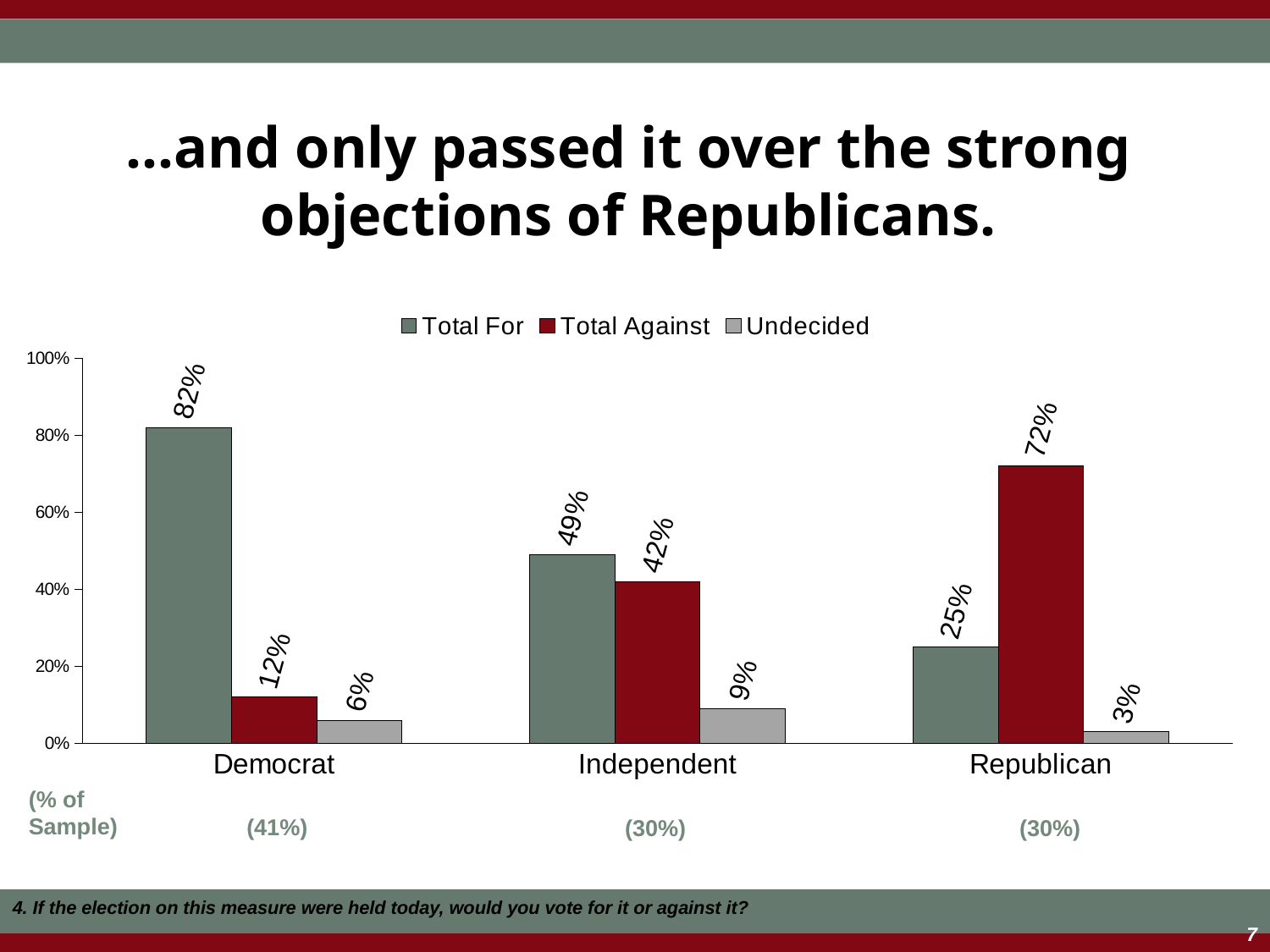
What kind of chart is shown on the slide? Bar chart What is the Total For value for Republican? 25% Which category has the highest Total For value? Democrat Which is larger for Democrat: Total Against or Undecided? Total Against How many categories are shown on the x axis? 3 Which category has the lowest Undecided value? Republican What is the difference between the Total For and Total Against values for Independent? 7% What is the Total For value for Democrat? 82% Which series is shown in dark red in the legend? Total Against What is the Total Against value for Republican? 72% What is the Undecided value for Independent? 9% How many series does the legend list? 3